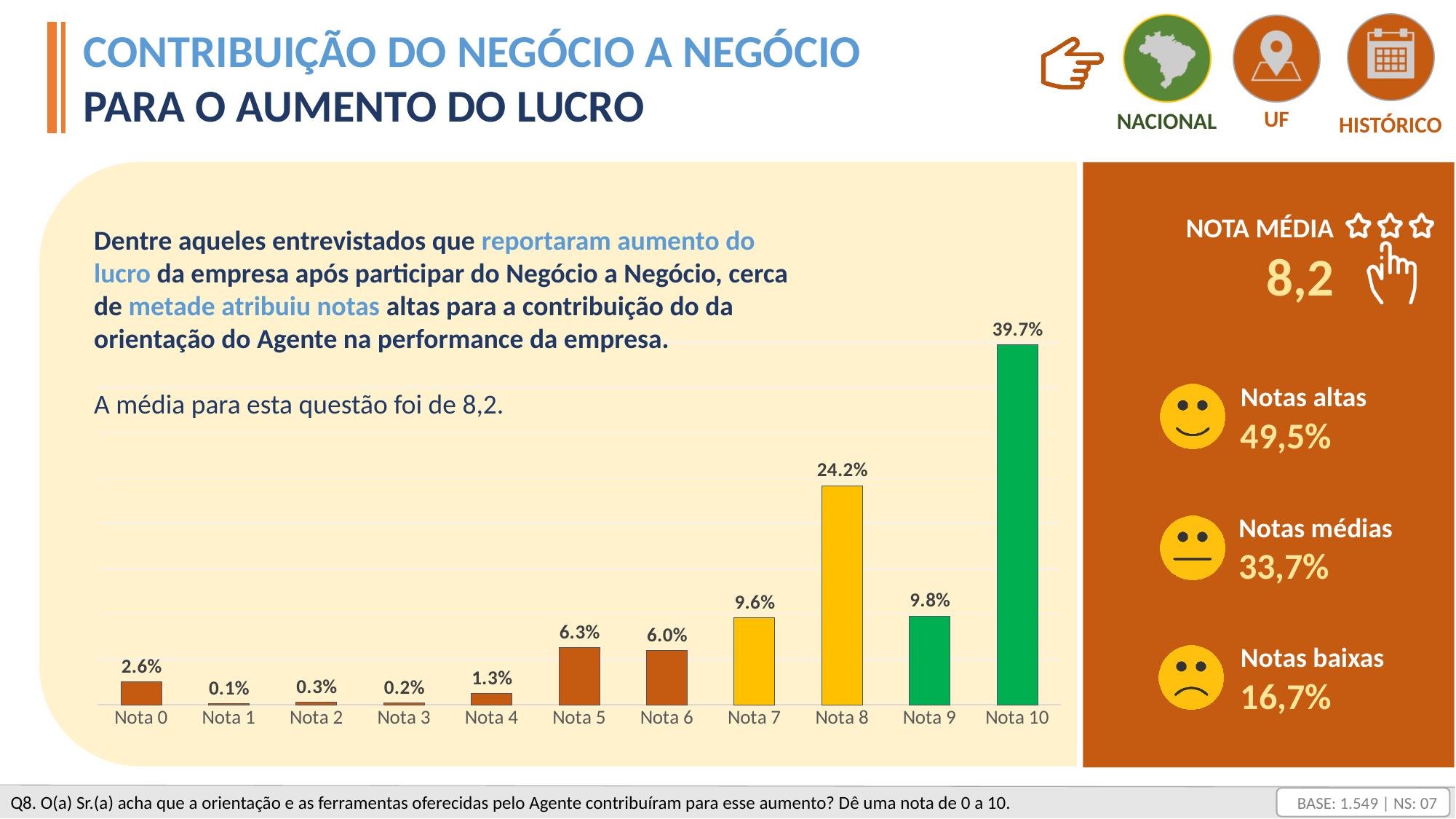
How many categories are shown on the x axis? 11 Which category has the lowest value? Nota 1 Which category has the highest value? Nota 10 What colour are the bars for Nota 9 and Nota 10? Green What is the combined value of Nota 9 and Nota 10? 49.5% What kind of chart is shown on the slide? Bar chart What is the value for Nota 10? 39.7% What is the value for Nota 0? 2.6% What is the difference between the values for Nota 9 and Nota 7? 0.2% Which is larger, the value for Nota 5 or the value for Nota 6? Nota 5 What is the difference between the values for Nota 10 and Nota 8? 15.5% What is the value for Nota 8? 24.2%